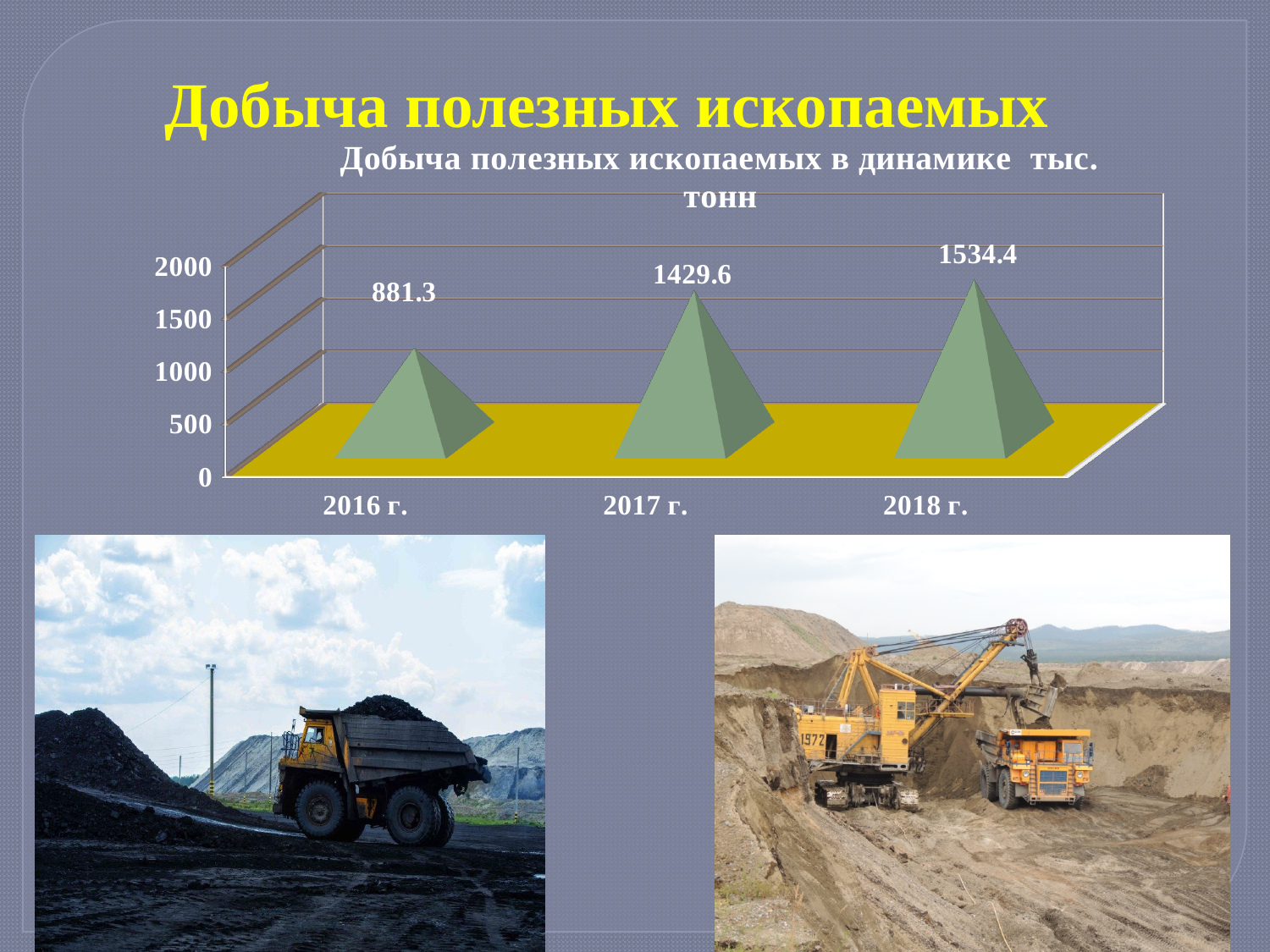
Which year has the highest value? 2018 г. What is the difference between the values for 2018 г. and 2017 г.? 104.8 Do the values rise or fall from 2016 г. to 2018 г.? rise What is the value for 2018 г.? 1534.4 What is the value for 2016 г.? 881.3 Which is larger, the value for 2016 г. or the value for 2017 г.? 2017 г. What is the title of the chart? Добыча полезных ископаемых в динамике тыс. тонн What is the difference between the values for 2017 г. and 2016 г.? 548.3 Which year has the lowest value? 2016 г. Is the value for 2016 г. greater or less than 1000? less How many years are shown on the x axis? 3 What is the value for 2017 г.? 1429.6